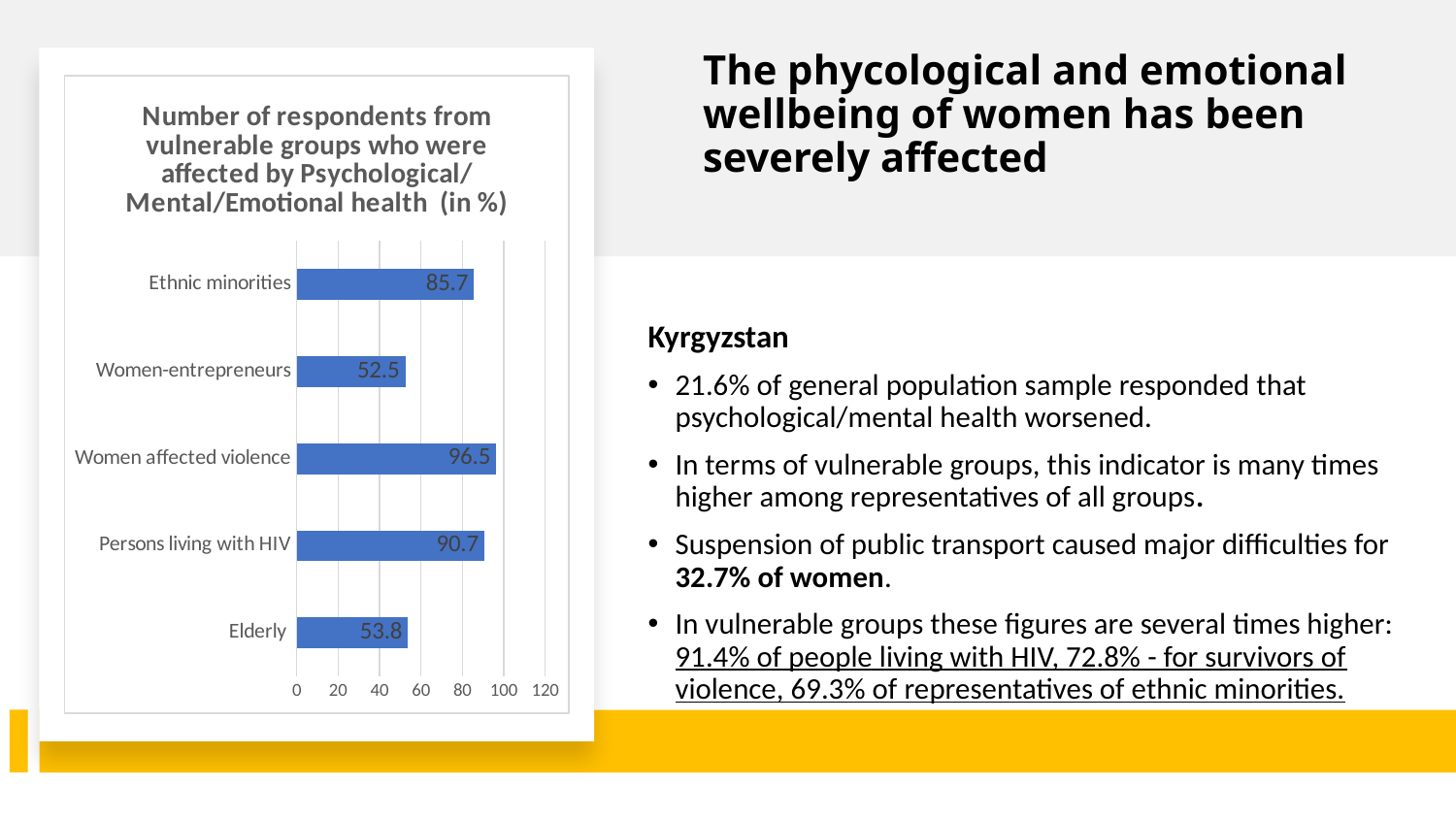
What is the value for Persons living with HIV? 90.7 What kind of chart is shown on the slide? bar chart Which category has the lowest value? Women-entrepreneurs Is the value for Elderly greater or less than 60? less How many categories are shown in the chart? 5 What is the value for Women-entrepreneurs? 52.5 What is the value for Ethnic minorities? 85.7 What is the difference between the values for Women affected violence and Elderly? 42.7 Which is larger, the value for Ethnic minorities or the value for Persons living with HIV? Persons living with HIV Which category has the highest value? Women affected violence What is the maximum value shown on the x axis? 120 What is the difference between the values for Persons living with HIV and Women-entrepreneurs? 38.2